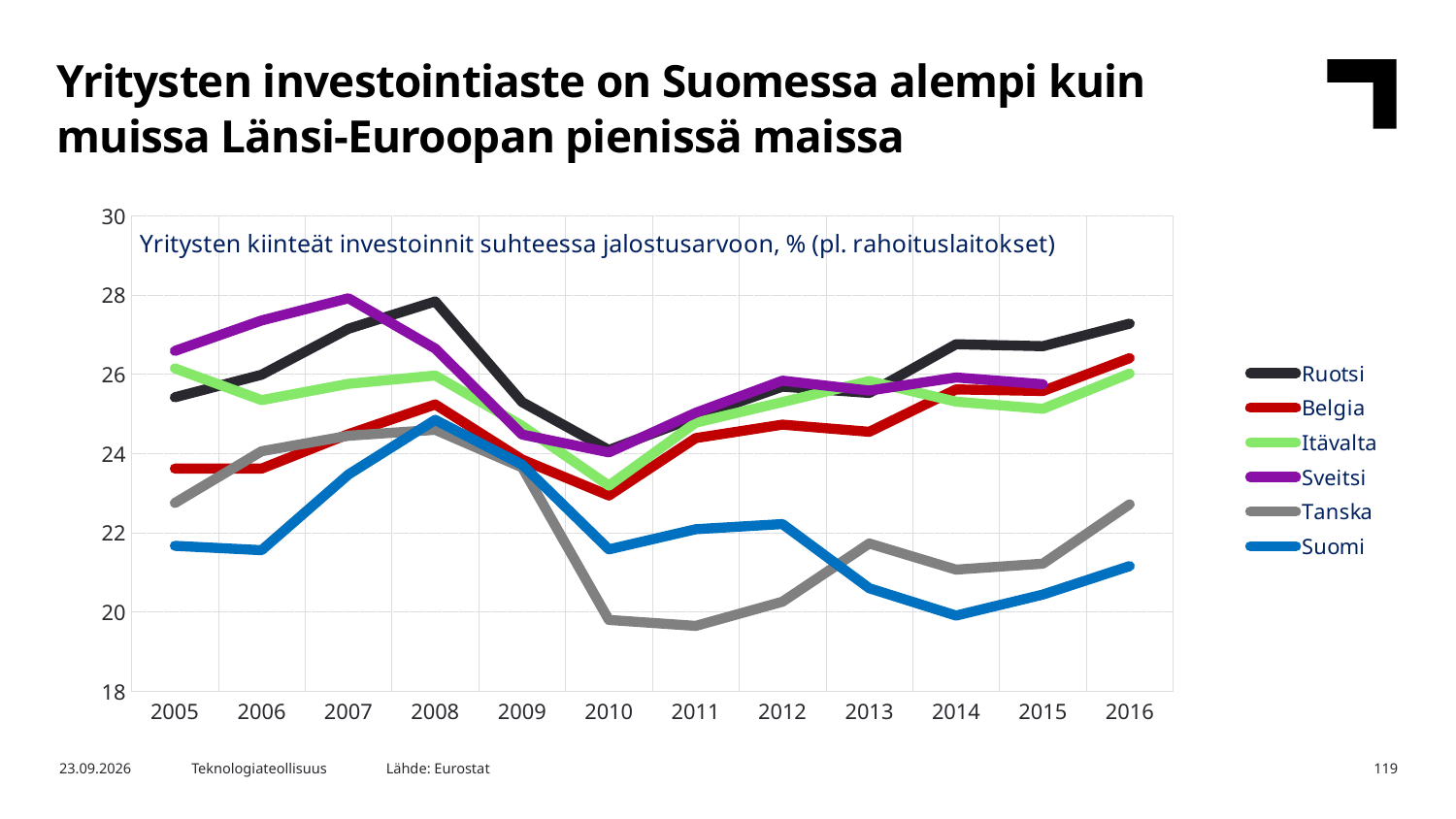
Is the value for Belgia in 2010 greater or less than 24? less Which is larger in 2010, the value for Suomi or the value for Tanska? Suomi How many series does the legend list? 6 What kind of chart is shown on the slide? line chart Is the value for Tanska in 2011 greater or less than 20? less How many years are shown on the x axis? 12 Which series has the highest value in 2016? Ruotsi Is the value for Ruotsi in 2008 greater or less than 26? greater What is the title printed inside the chart area? Yritysten kiinteät investoinnit suhteessa jalostusarvoon, % (pl. rahoituslaitokset) In which year does Suomi reach its highest value? 2008 Which series has the lowest value in 2016? Suomi Does the value for Suomi rise or fall from 2008 to 2014? fall